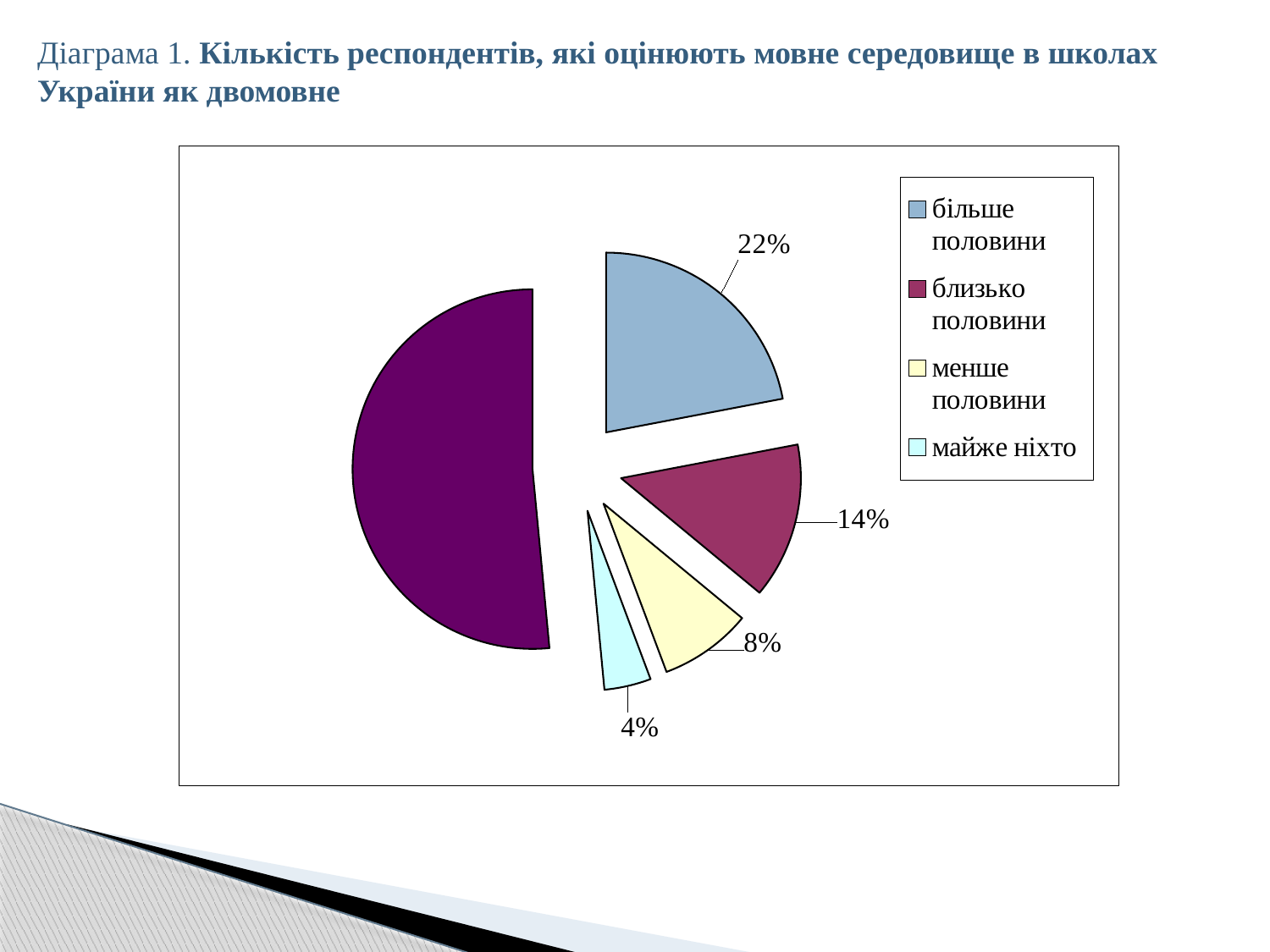
Which slice is the smallest in the pie chart? майже ніхто How many slices does the pie chart have? 5 What percentage is shown for the "менше половини" slice? 8% What is the difference in percentage points between the "менше половини" and "майже ніхто" slices? 4 What percentage is shown for the "майже ніхто" slice? 4% What percentage is shown for the "більше половини" slice? 22% How many entries does the legend list? 4 What percentage is shown for the "близько половини" slice? 14% What is the difference in percentage points between the "більше половини" and "близько половини" slices? 8 Which is larger, the "близько половини" slice or the "менше половини" slice? близько половини What kind of chart is shown on the slide? pie chart What colour is the "майже ніхто" slice? light cyan